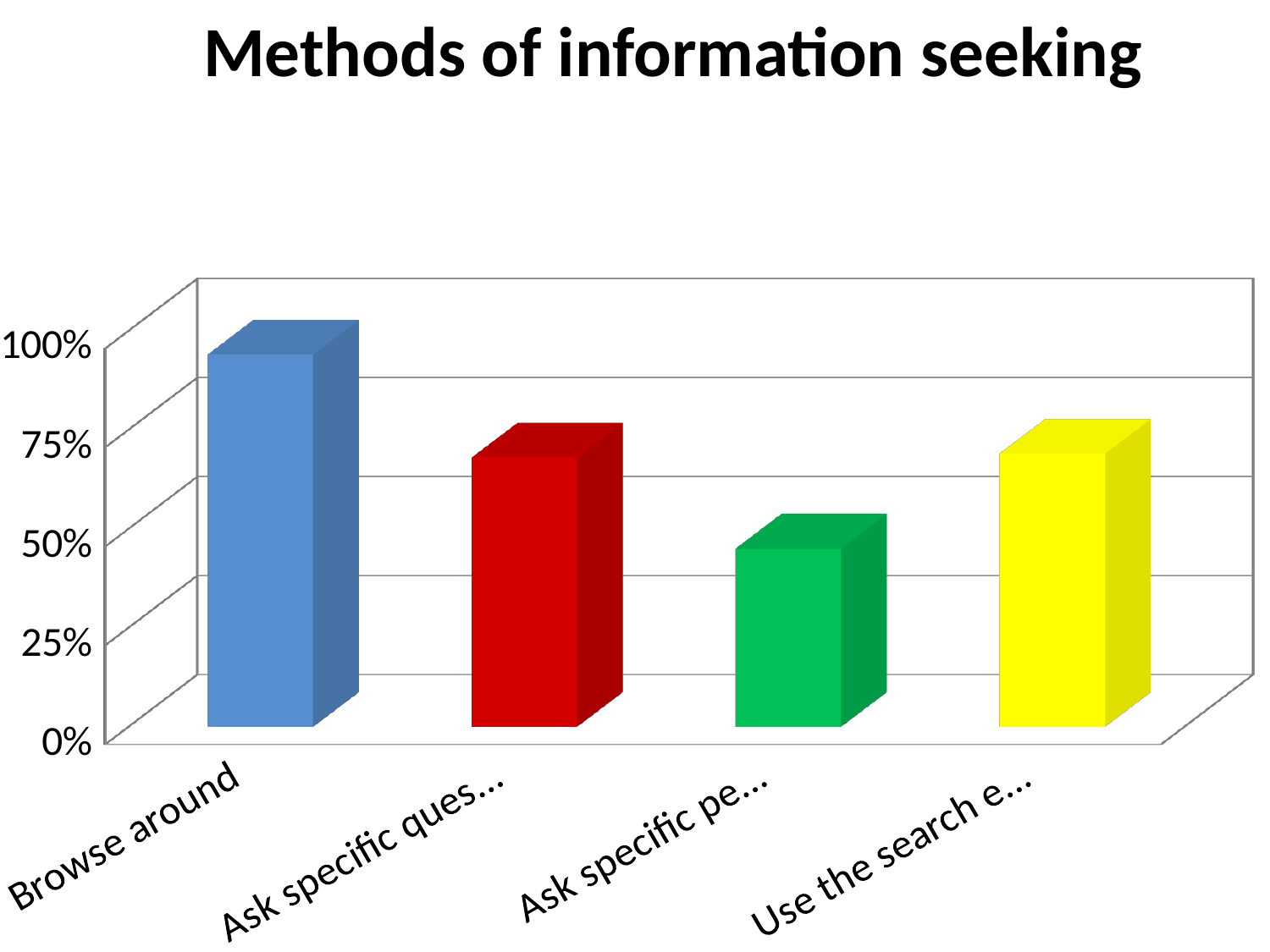
What colour is the bar for Browse around? blue What is the title of the chart? Methods of information seeking What kind of chart is shown on the slide? bar chart Is the value for Browse around greater or less than 75%? greater How many categories are shown on the x axis of the chart? 4 Is the value for Ask specific ques... greater or less than 50%? greater Which category has the lowest value in the chart? Ask specific pe... Which category has the highest value in the chart? Browse around Which is larger, the value for Browse around or the value for Ask specific pe...? Browse around Is the value for Use the search e... greater or less than 50%? greater